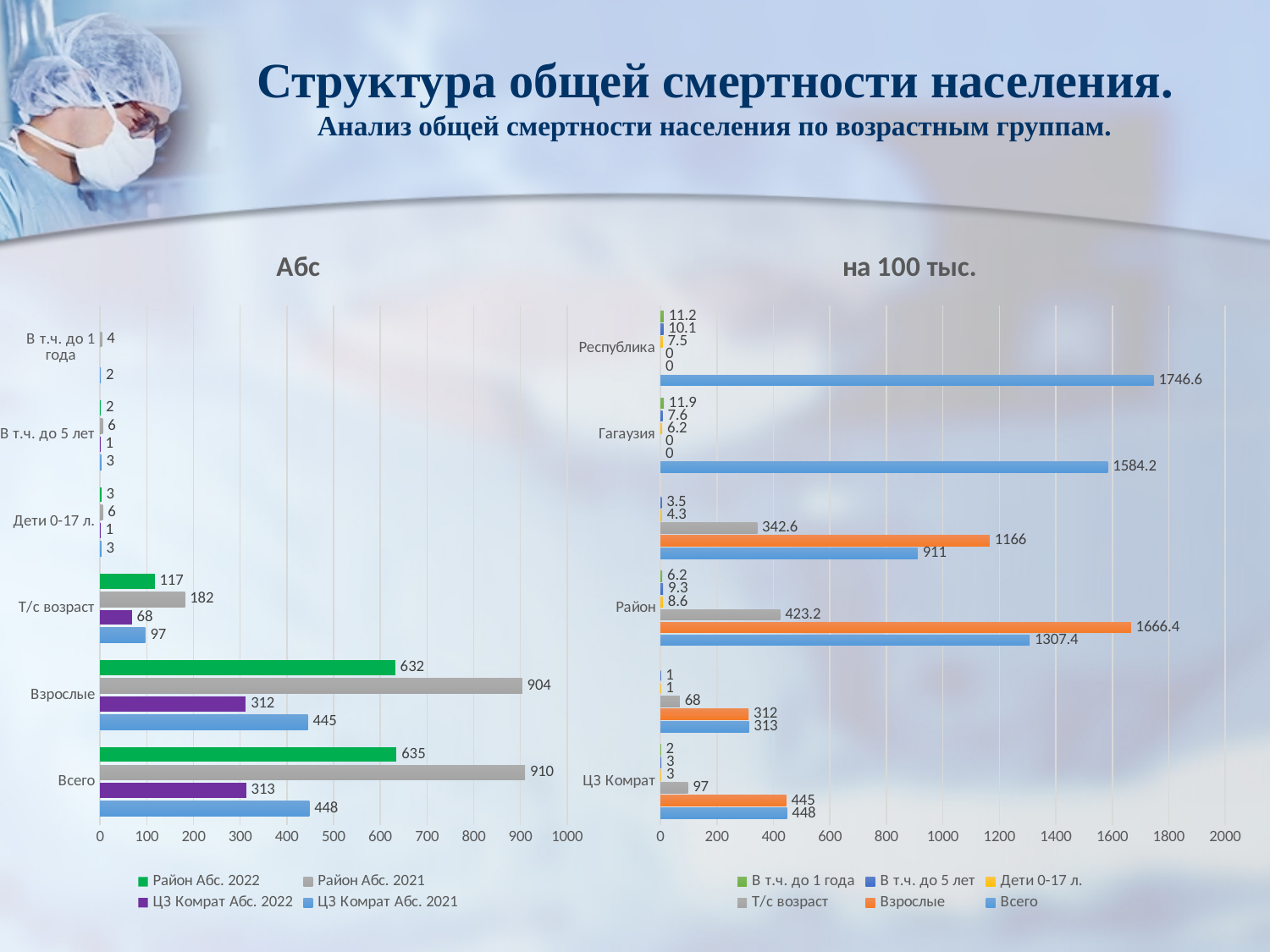
How many categories are shown on the vertical axis of the left chart "Абс"? 6 In the left chart "Абс", what is the difference between Район Абс. 2021 and Район Абс. 2022 for Всего? 275 In the left chart "Абс", what is the value of Район Абс. 2022 for Т/с возраст? 117 In the right chart "на 100 тыс.", what is the value of Взрослые for Район? 1666.4 In the left chart "Абс", which series has the highest value for Взрослые? Район Абс. 2021 How many series does the legend of the left chart "Абс" list? 4 What kind of chart is the left chart titled "Абс"? bar chart In the right chart "на 100 тыс.", what is the value of Всего for Республика? 1746.6 In the right chart "на 100 тыс.", which has the larger Всего value, Республика or Гагаузия? Республика How many series does the legend of the right chart "на 100 тыс." list? 6 In the left chart "Абс", what is the value of Район Абс. 2021 for Всего? 910 In the left chart "Абс", what is the value of ЦЗ Комрат Абс. 2022 for Взрослые? 312